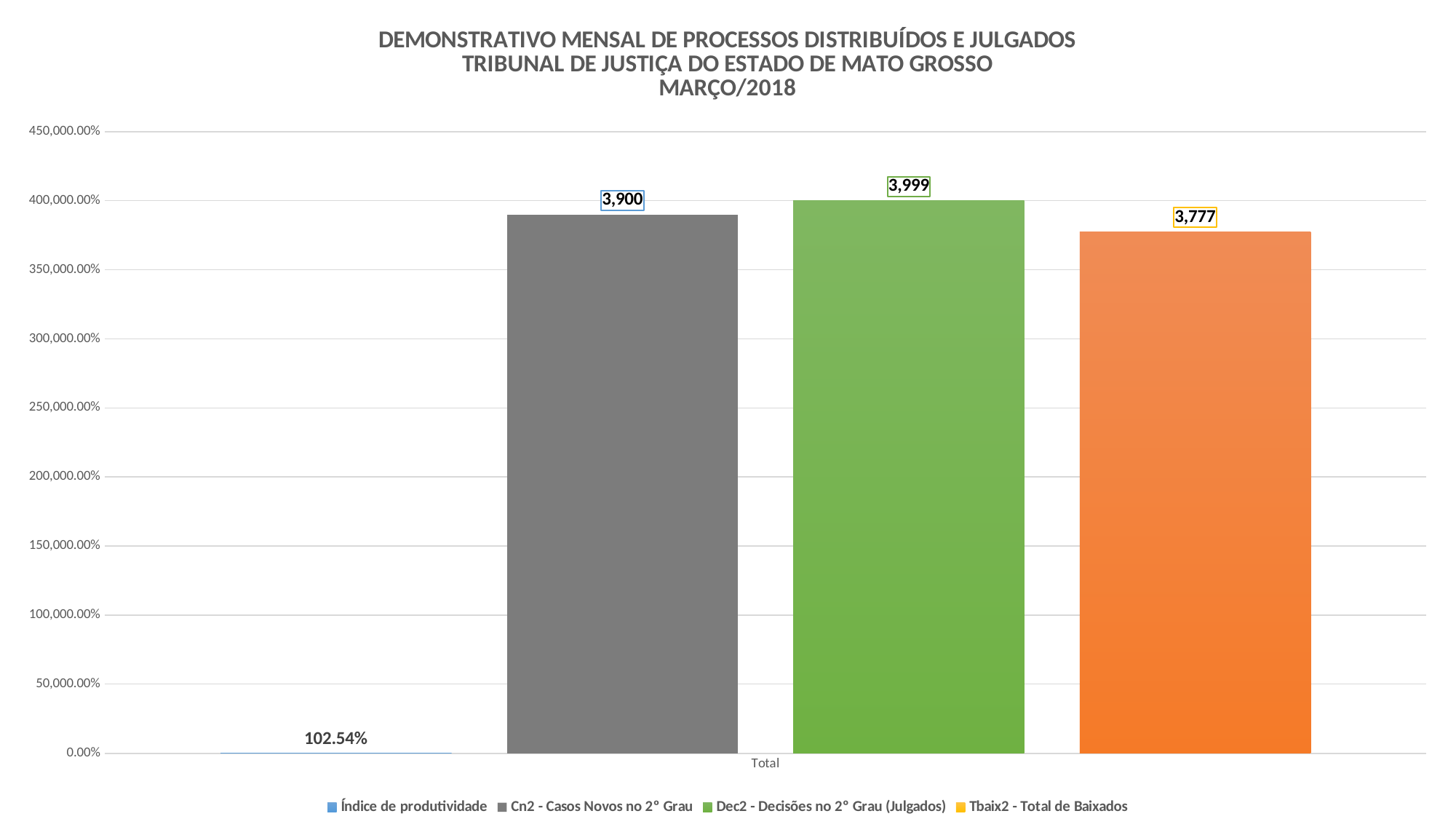
What is the value shown for Cn2 - Casos Novos no 2° Grau? 3,900 What is the difference between the Cn2 - Casos Novos no 2° Grau value and the Tbaix2 - Total de Baixados value? 123 What is the value shown for Dec2 - Decisões no 2° Grau (Julgados)? 3,999 Which series has the smallest value? Índice de produtividade What is the value shown for Tbaix2 - Total de Baixados? 3,777 Which series has the tallest bar? Dec2 - Decisões no 2° Grau (Julgados) How many series does the legend list? 4 What is the label of the single category on the x axis? Total What is the value shown for Índice de produtividade? 102.54% Which is larger, the value for Cn2 - Casos Novos no 2° Grau or the value for Tbaix2 - Total de Baixados? Cn2 - Casos Novos no 2° Grau What kind of chart is shown on the slide? Bar chart What is the difference between the Dec2 - Decisões no 2° Grau (Julgados) value and the Cn2 - Casos Novos no 2° Grau value? 99